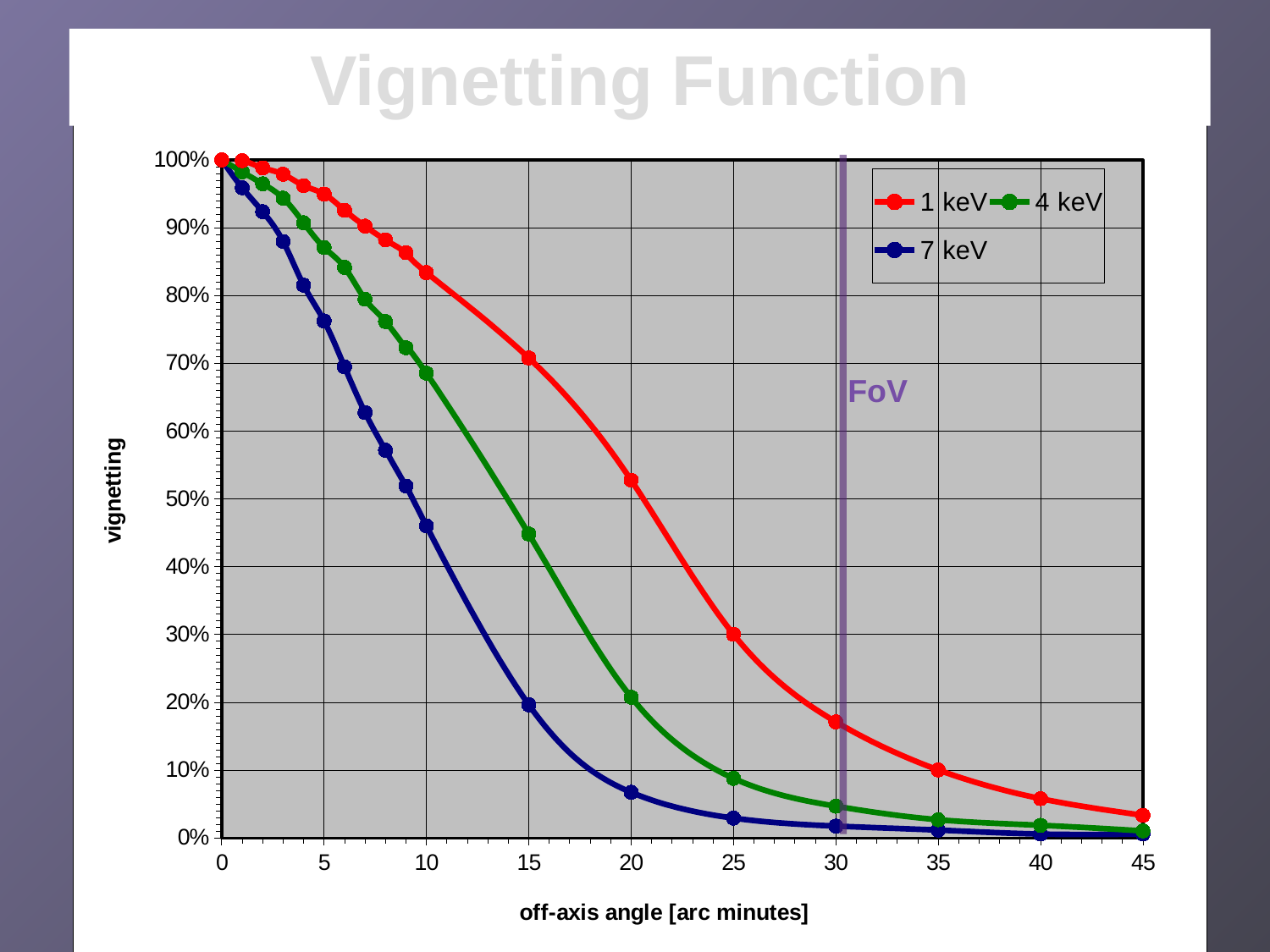
Which series has the highest vignetting value at 30 arc minutes? 1 keV What kind of chart is shown on the slide? line chart Is the vignetting value for 7 keV at 10 arc minutes greater or less than 60%? less Which series has the lowest vignetting value at 15 arc minutes? 7 keV Is the vignetting value for 4 keV at 25 arc minutes greater or less than 20%? less What are the series names listed in the legend? 1 keV, 4 keV, 7 keV Do the vignetting values rise or fall as the off-axis angle increases? fall At an off-axis angle of 20 arc minutes, which series has the larger vignetting value, 1 keV or 7 keV? 1 keV How many series does the legend list? 3 What is the title of the chart? Vignetting Function What is the vignetting value for 1 keV at an off-axis angle of 0 arc minutes? 100% Is the vignetting value for 1 keV at 15 arc minutes greater or less than 60%? greater